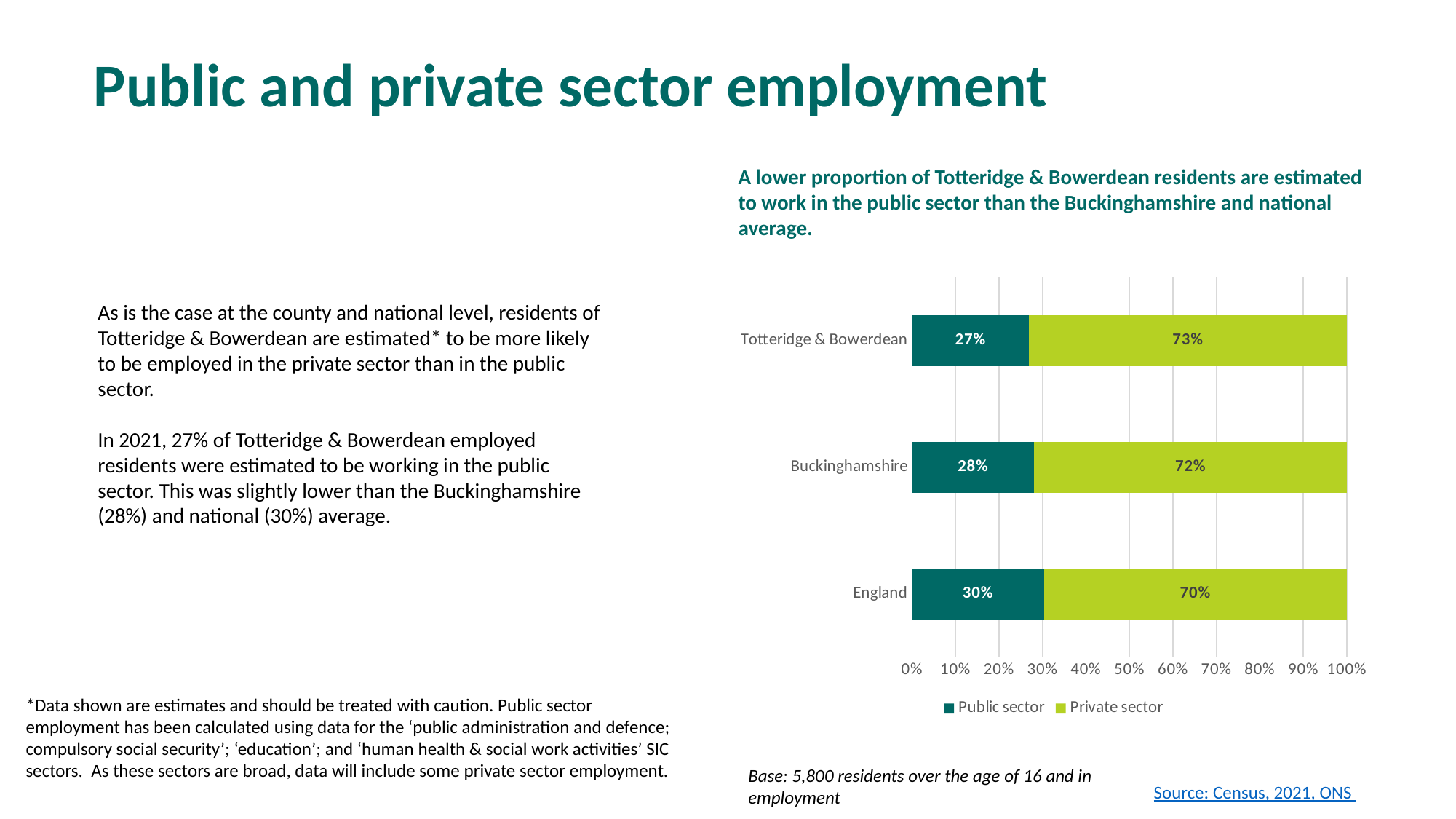
How many categories are shown on the chart? 3 What is the Public sector value for Totteridge & Bowerdean? 27% What kind of chart is shown on the slide? Stacked bar chart Which is larger, the Private sector value for Totteridge & Bowerdean or for Buckinghamshire? Totteridge & Bowerdean Which category has the lowest Private sector value? England What is the total of the stacked bar for Buckinghamshire? 100% Which category has the highest Public sector value? England How many series does the legend list? 2 What is the Public sector value for England? 30% What is the difference between the Public sector values for England and Totteridge & Bowerdean? 3% Which colour represents the Public sector series in the chart? Dark teal What is the Private sector value for Buckinghamshire? 72%